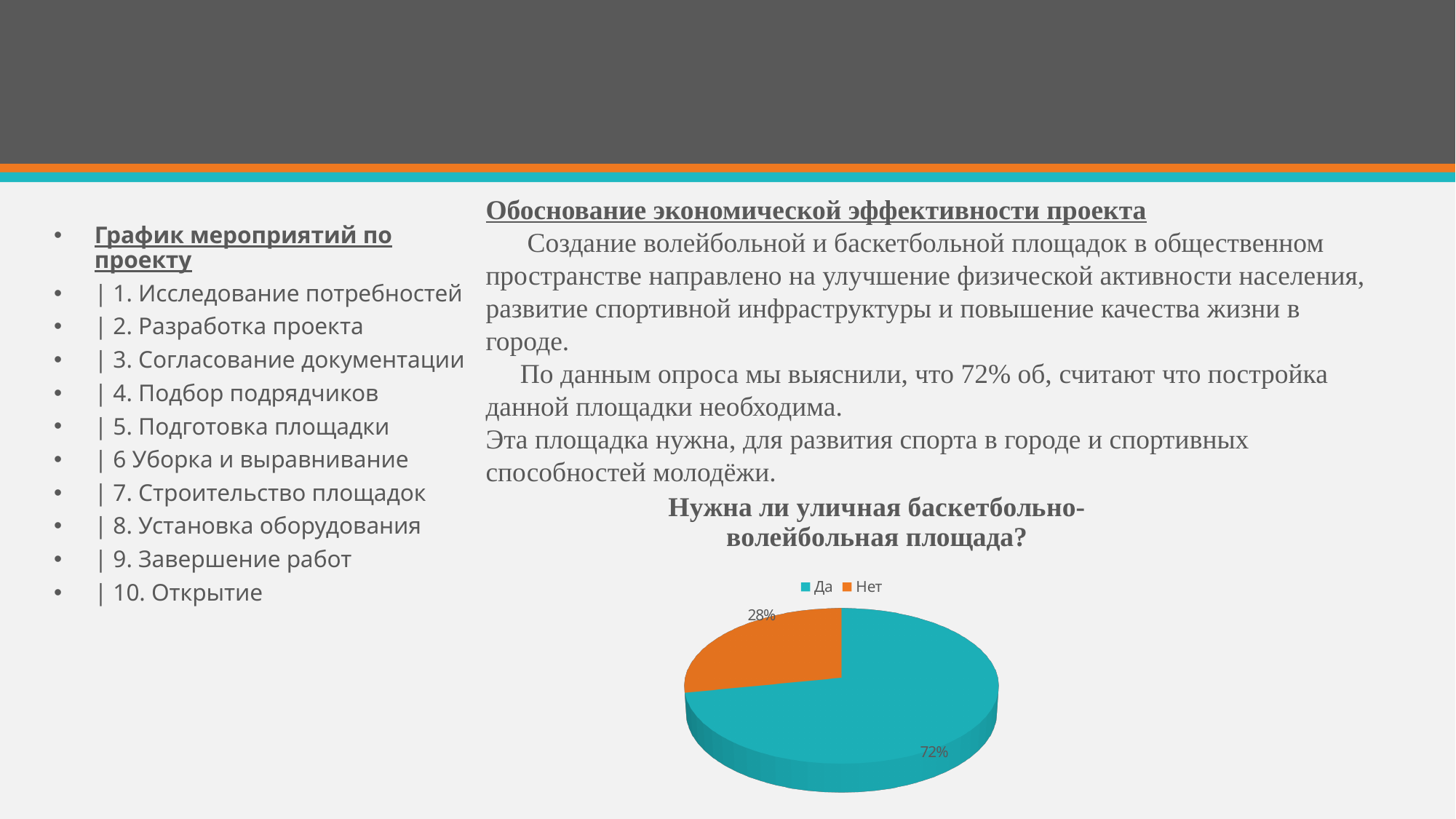
How many slices does the pie chart have? 2 What colour is the "Нет" slice in the pie chart? orange What is the difference between the "Да" and "Нет" shares in the pie chart? 44% What is the value for "Да" in the pie chart? 72% What kind of chart is shown on the slide? pie chart Which slice of the pie chart is the largest? Да What is the value for "Нет" in the pie chart? 28% What share of the pie does the "Да" slice take? 72% Which slice of the pie chart is the smallest? Нет What is the title of the pie chart? Нужна ли уличная баскетбольно-волейбольная площада? Which is larger in the pie chart, "Да" or "Нет"? Да How many entries does the legend of the pie chart list? 2